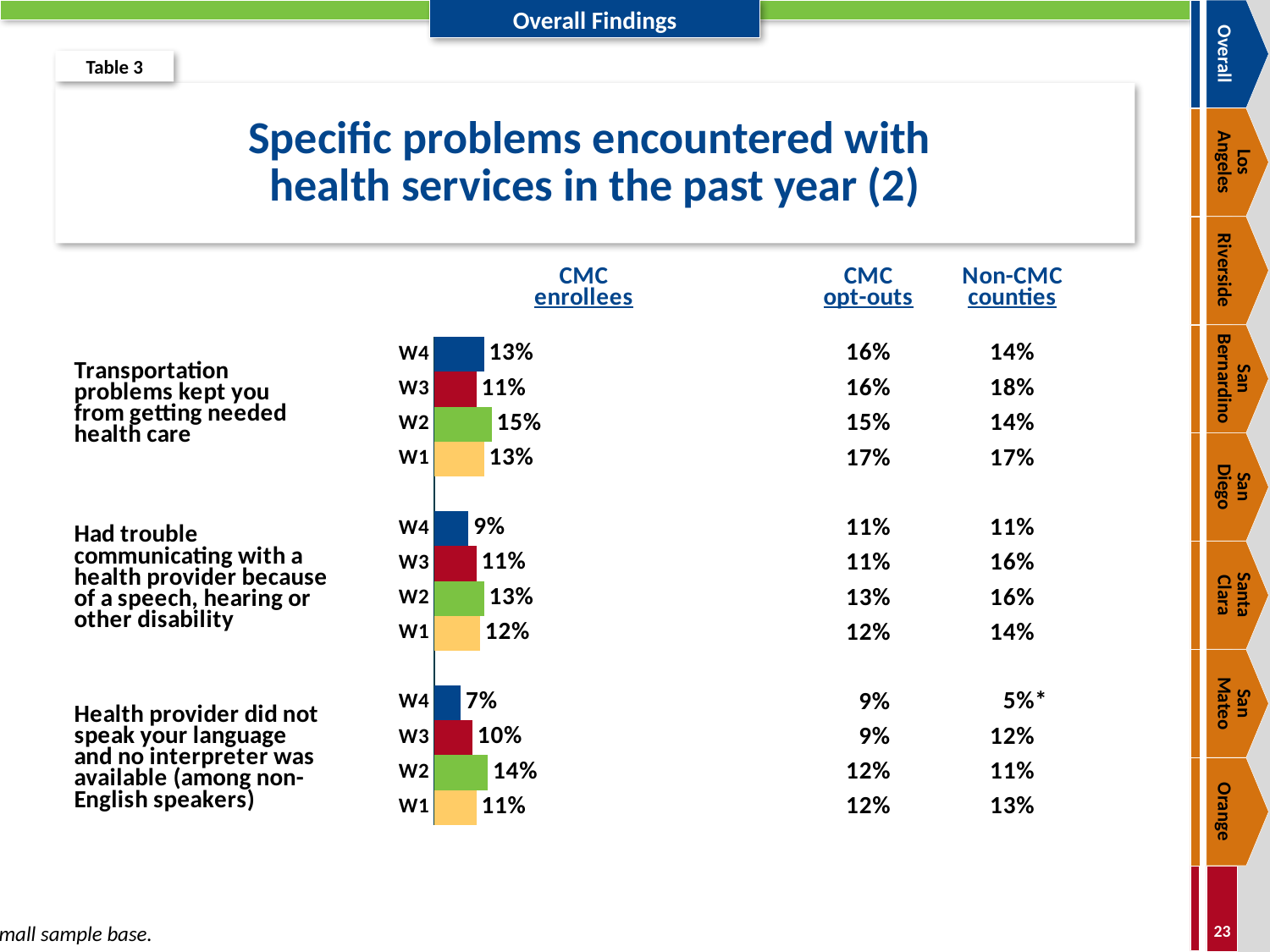
In the 'Health provider did not speak your language' chart, what is the difference between the W2 and W4 CMC enrollees values? 7% In the 'Transportation problems kept you from getting needed health care' chart, which wave has the lowest CMC enrollees value? W3 In the 'Had trouble communicating with a health provider' chart, which is larger for CMC enrollees, W1 or W3? W1 In the 'Had trouble communicating with a health provider' chart, what is the difference between the W2 and W4 CMC enrollees values? 4% In the 'Health provider did not speak your language and no interpreter was available' chart, what is the CMC enrollees value for W4? 7% In the 'Health provider did not speak your language' chart, which wave has the highest CMC enrollees value? W2 What colour is the W4 bar in each of the CMC enrollees charts? Blue In the 'Had trouble communicating with a health provider because of a speech, hearing or other disability' chart, what is the CMC enrollees value for W4? 9% In the 'Transportation problems kept you from getting needed health care' chart, what is the CMC enrollees value for W2? 15% In the 'Transportation problems kept you from getting needed health care' chart, which wave has the highest CMC enrollees value? W2 How many bars are shown in the 'Transportation problems kept you from getting needed health care' chart? 4 What type of chart is used to show the CMC enrollees values on this slide? Bar chart